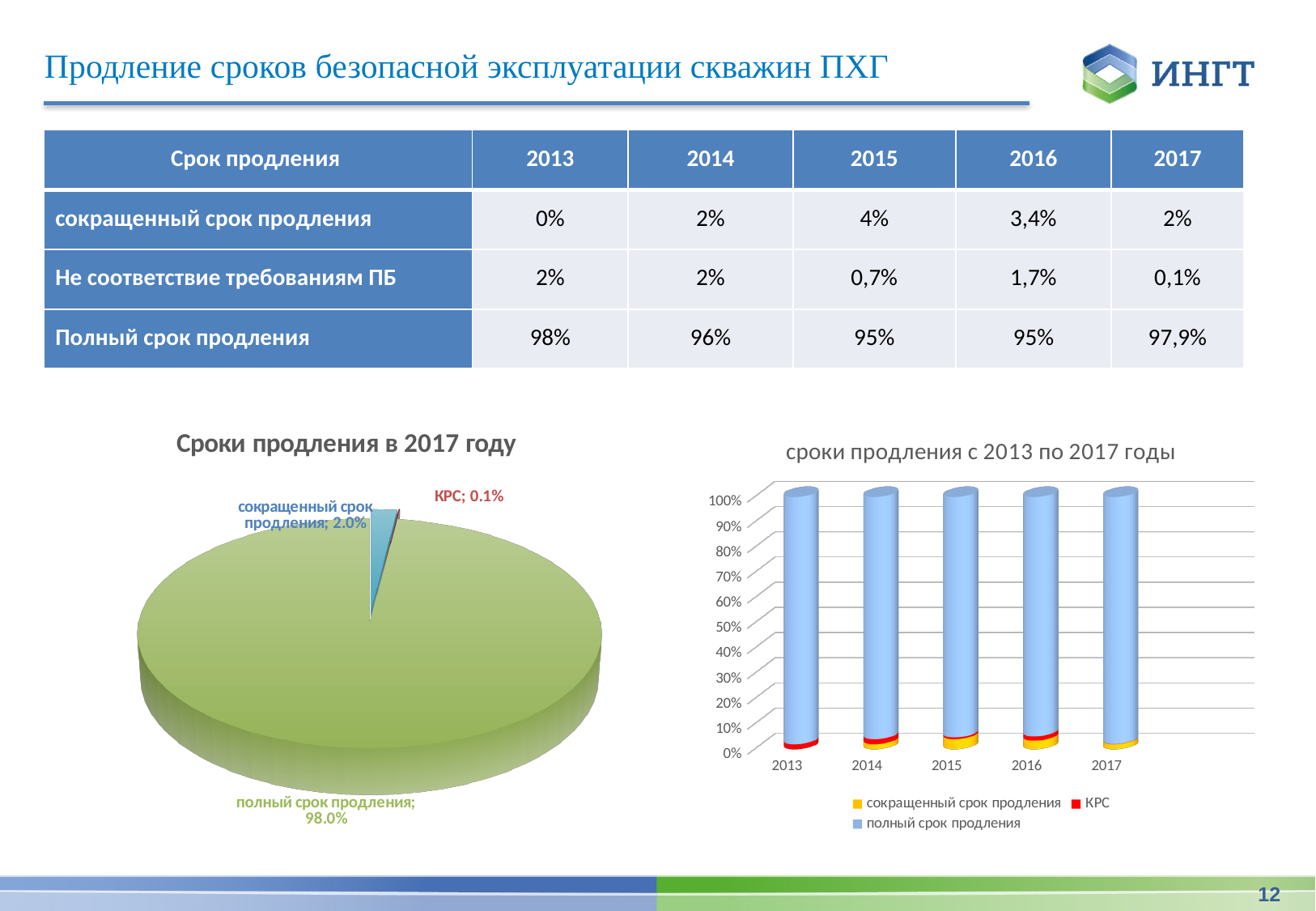
In the chart 'сроки продления с 2013 по 2017 годы', how many years are shown on the x axis? 5 In the pie chart 'Сроки продления в 2017 году', what is the value for 'полный срок продления'? 98.0% In the pie chart 'Сроки продления в 2017 году', which category has the largest slice? полный срок продления What kind of chart is 'сроки продления с 2013 по 2017 годы'? bar chart In the chart 'сроки продления с 2013 по 2017 годы', is the value for 'полный срок продления' in 2015 greater or less than 80%? greater In the pie chart 'Сроки продления в 2017 году', what is the value for 'КРС'? 0.1% In the pie chart 'Сроки продления в 2017 году', what is the value for 'сокращенный срок продления'? 2.0% In the pie chart 'Сроки продления в 2017 году', how many slices are there? 3 What kind of chart is the chart on the left of the slide? pie chart In the chart 'сроки продления с 2013 по 2017 годы', how many series does the legend list? 3 In the pie chart 'Сроки продления в 2017 году', which category has the smallest slice? КРС In the pie chart 'Сроки продления в 2017 году', what is the difference between 'сокращенный срок продления' and 'КРС'? 1.9%